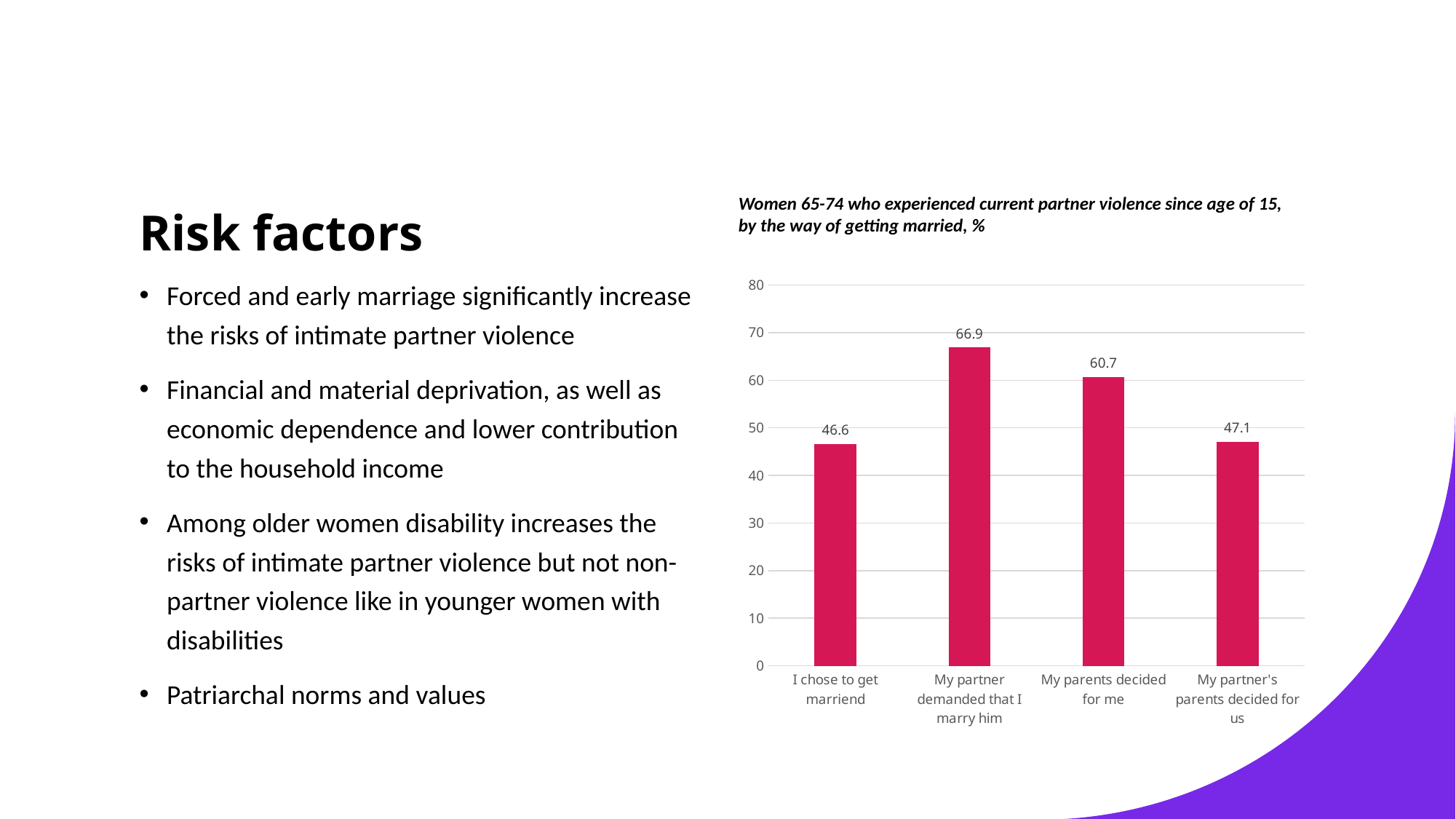
What is the value for 'My partner's parents decided for us'? 47.1 What is the difference between the values for 'My partner demanded that I marry him' and 'I chose to get marriend'? 20.3 What kind of chart is shown on the slide? Bar chart Which is larger: the value for 'My parents decided for me' or 'My partner's parents decided for us'? My parents decided for me Which category has the highest value? My partner demanded that I marry him What is the value for 'I chose to get marriend'? 46.6 What is the value for 'My partner demanded that I marry him'? 66.9 What is the value for 'My parents decided for me'? 60.7 Is the value for 'My parents decided for me' greater or less than 50? greater What is the title of the chart? Women 65-74 who experienced current partner violence since age of 15, by the way of getting married, % How many categories are shown on the chart? 4 Which category has the lowest value? I chose to get marriend